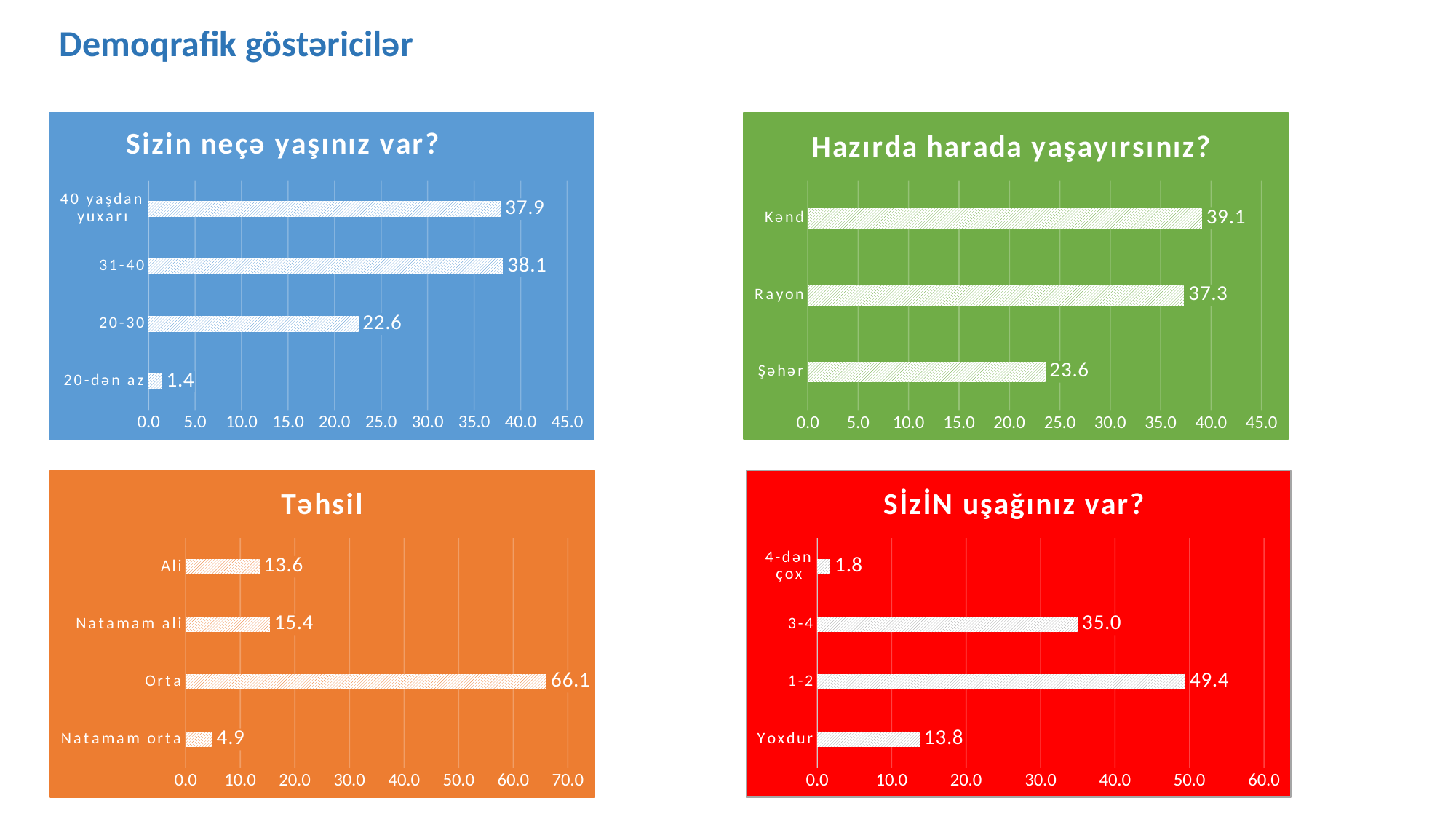
In the chart titled "Təhsil", which category has the lowest value? Natamam orta In the chart titled "Təhsil", what is the value for Orta? 66.1 In the chart titled "SİZİN uşağınız var?", which category has the highest value? 1-2 In the chart titled "Hazırda harada yaşayırsınız?", what is the value for Rayon? 37.3 In the chart titled "Sizin neçə yaşınız var?", which category has the lowest value? 20-dən az In the chart titled "Hazırda harada yaşayırsınız?", which category has the highest value? Kənd In the chart titled "Təhsil", which is larger, the value for Ali or the value for Natamam ali? Natamam ali In the chart titled "Sizin neçə yaşınız var?", how many categories are shown? 4 What kind of chart is the chart titled "SİZİN uşağınız var?"? bar chart In the chart titled "Sizin neçə yaşınız var?", what is the value for 20-30? 22.6 In the chart titled "SİZİN uşağınız var?", what is the value for Yoxdur? 13.8 In the chart titled "Hazırda harada yaşayırsınız?", what is the difference between the values for Kənd and Şəhər? 15.5